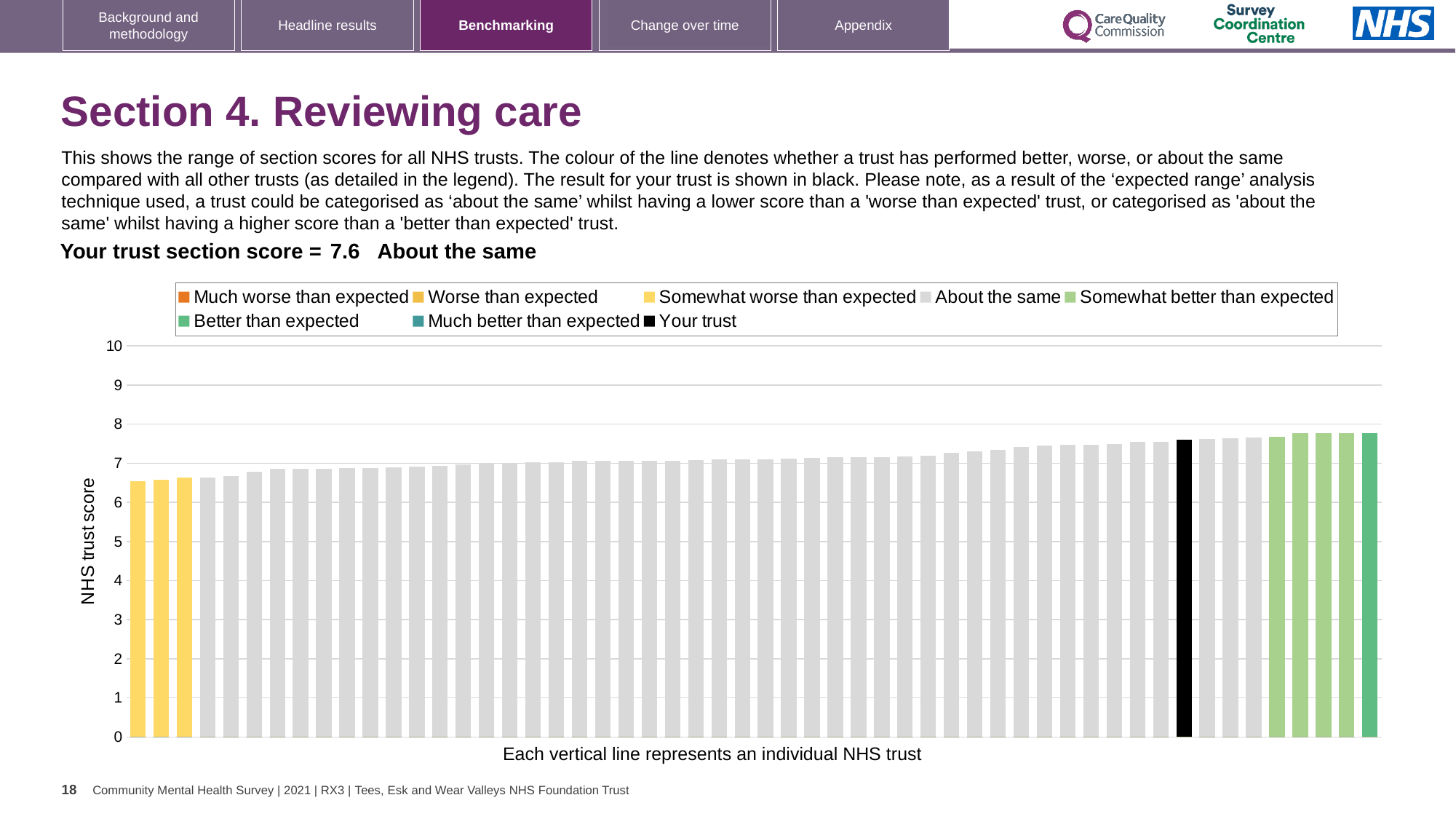
Do the bar values rise or fall from left to right along the x axis? rise What colour is the bar for Your trust? black Is the value of the lowest bar greater or less than 7? less What is the label on the y axis? NHS trust score What is the section score for Your trust? 7.6 Is the value for Your trust greater or less than 7? greater Is the value of the highest bar greater or less than 8? less Which category is Your trust placed in for this section? About the same What kind of chart is shown on the slide? bar chart How many entries does the chart legend list? 8